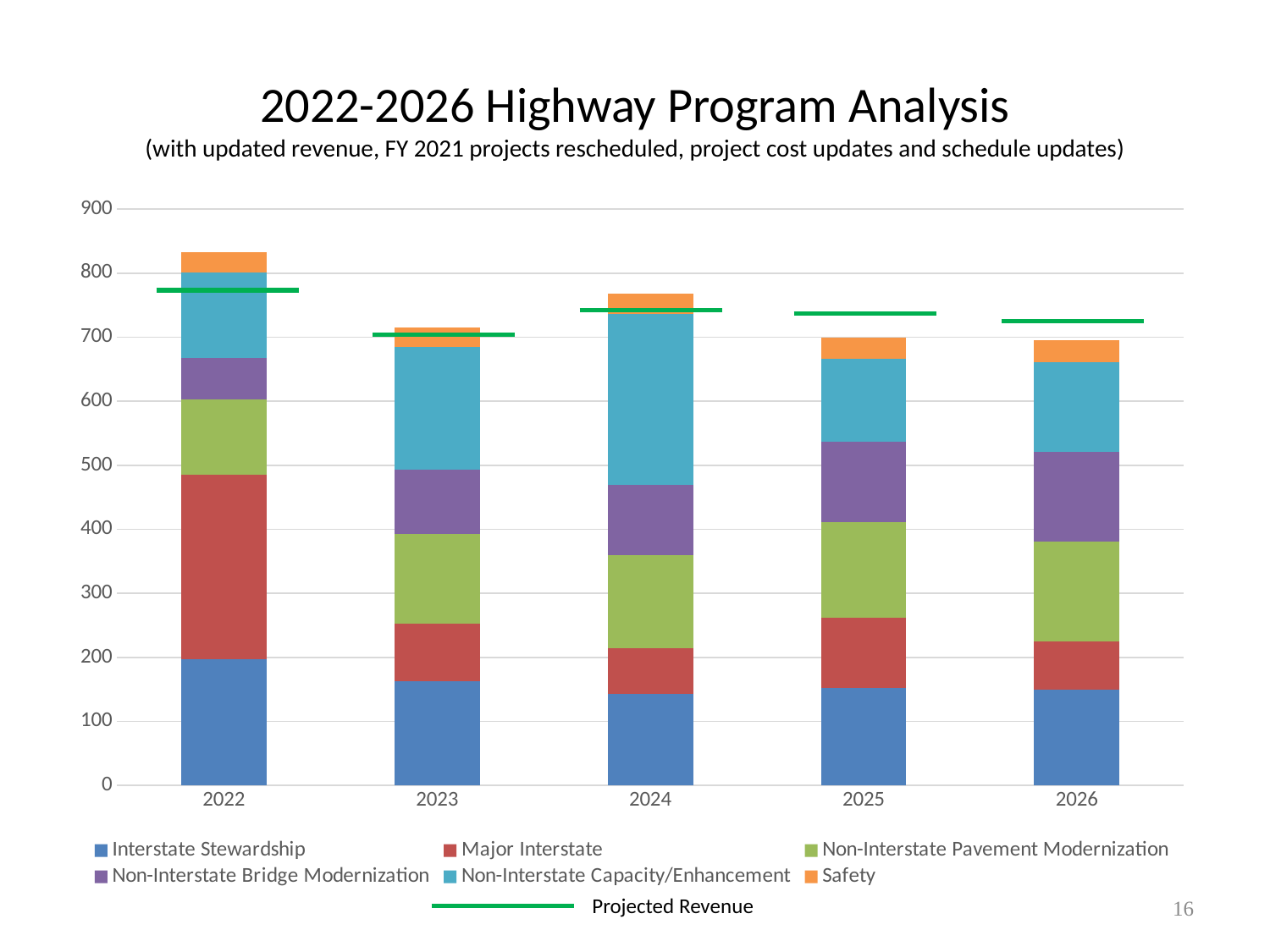
Which year has the tallest stacked bar? 2022 What type of chart is shown on the slide? Stacked bar chart Which series forms the largest segment of the 2022 bar? Major Interstate Is the total stacked bar for 2023 greater or less than 800? less Which is larger, the total bar for 2023 or the total bar for 2024? 2024 What is the title of the chart? 2022-2026 Highway Program Analysis How many stacked series does the legend list, excluding the Projected Revenue line? 6 Is the total stacked bar for 2024 greater or less than 700? greater Does the total bar height rise or fall from 2022 to 2023? fall Is the total stacked bar for 2022 greater or less than 800? greater How many years (categories) are shown on the x axis? 5 What does the green horizontal line on each bar represent? Projected Revenue